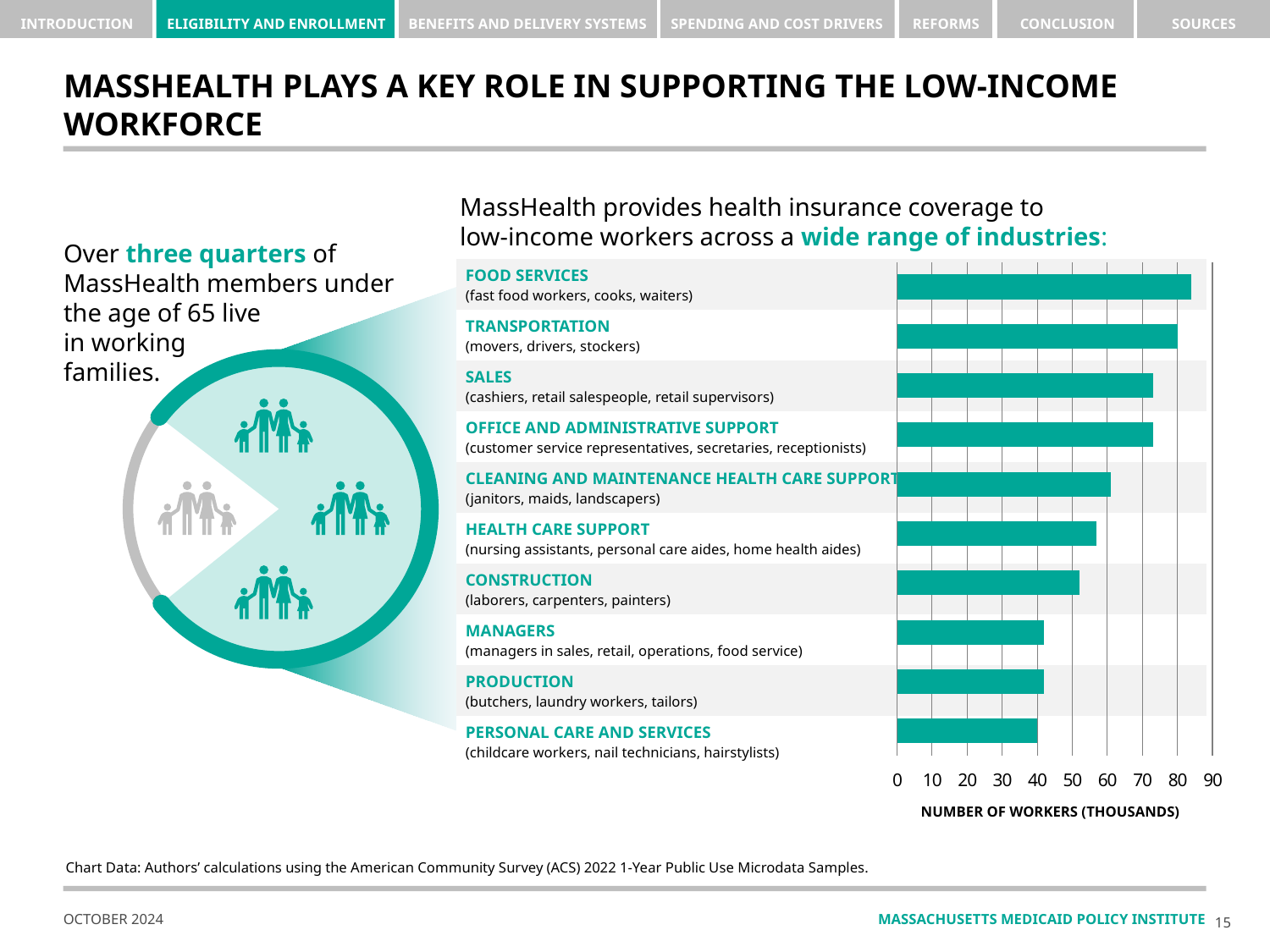
Which industry has the lowest number of workers in the chart? Personal care and services Which has more workers, Transportation or Cleaning and maintenance? Transportation How many industry categories are plotted in the chart? 10 Which has more workers, Health care support or Personal care and services? Health care support Is the value for Health care support greater or less than 60? less What kind of chart is shown on the slide? bar chart Is the value for Managers greater or less than 50? less What is the label of the horizontal axis of the chart? Number of workers (thousands) Is the value for Transportation greater or less than 70? greater Which industry has the highest number of workers in the chart? Food services